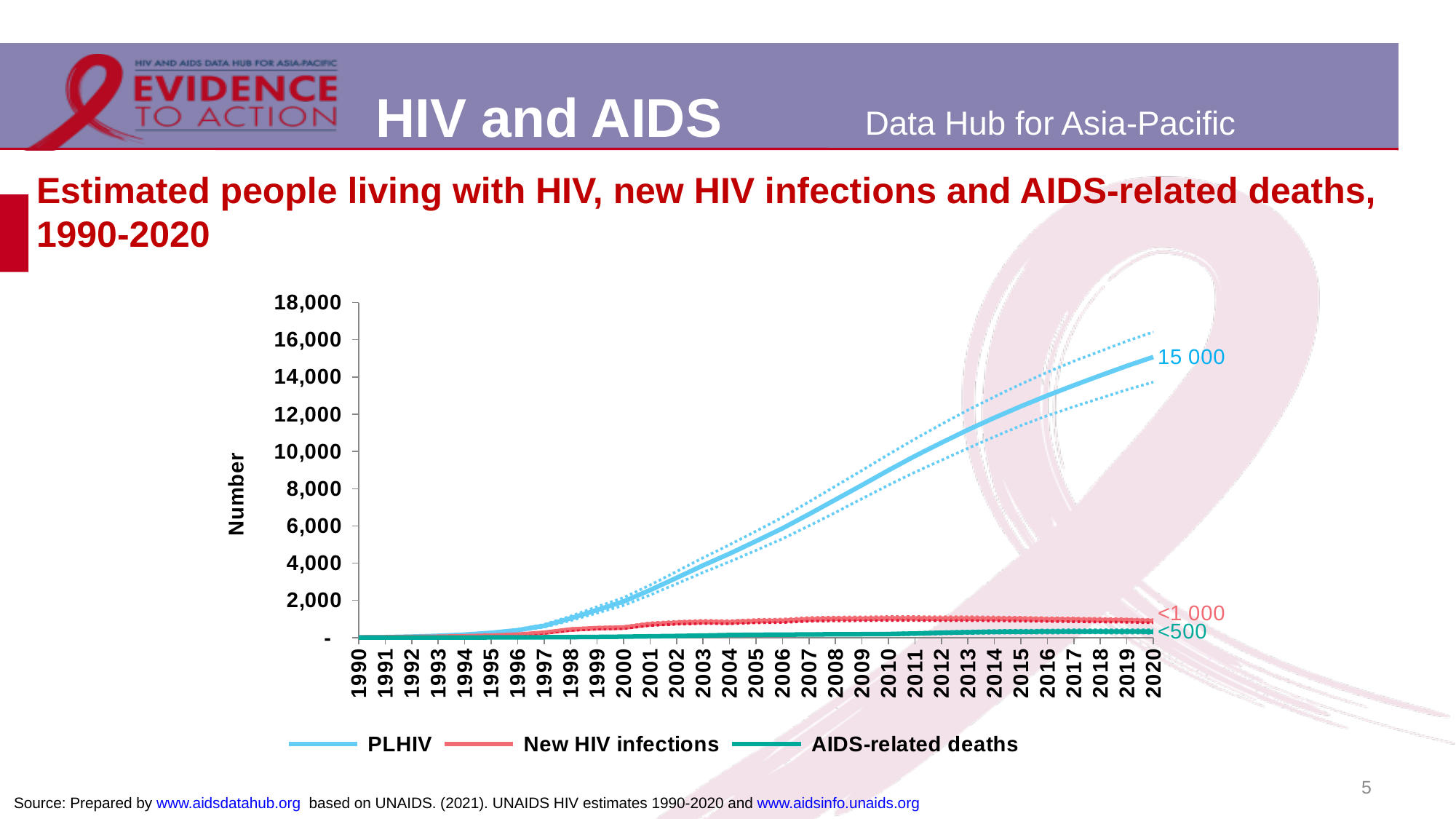
Which series has the lowest value in 2020? AIDS-related deaths What is the labelled value for PLHIV in 2020? 15 000 What is the title of the y axis? Number What is the labelled value for AIDS-related deaths in 2020? <500 Is the value for PLHIV in 2015 greater or less than 10,000? greater Which series has the highest value in 2020? PLHIV What kind of chart is shown on the slide? line chart How many series does the legend list? 3 Is the value for PLHIV in 2000 greater or less than 4,000? less How many years are shown on the x axis? 31 What is the labelled value for New HIV infections in 2020? <1 000 Does the PLHIV line rise or fall from 1990 to 2020? rise